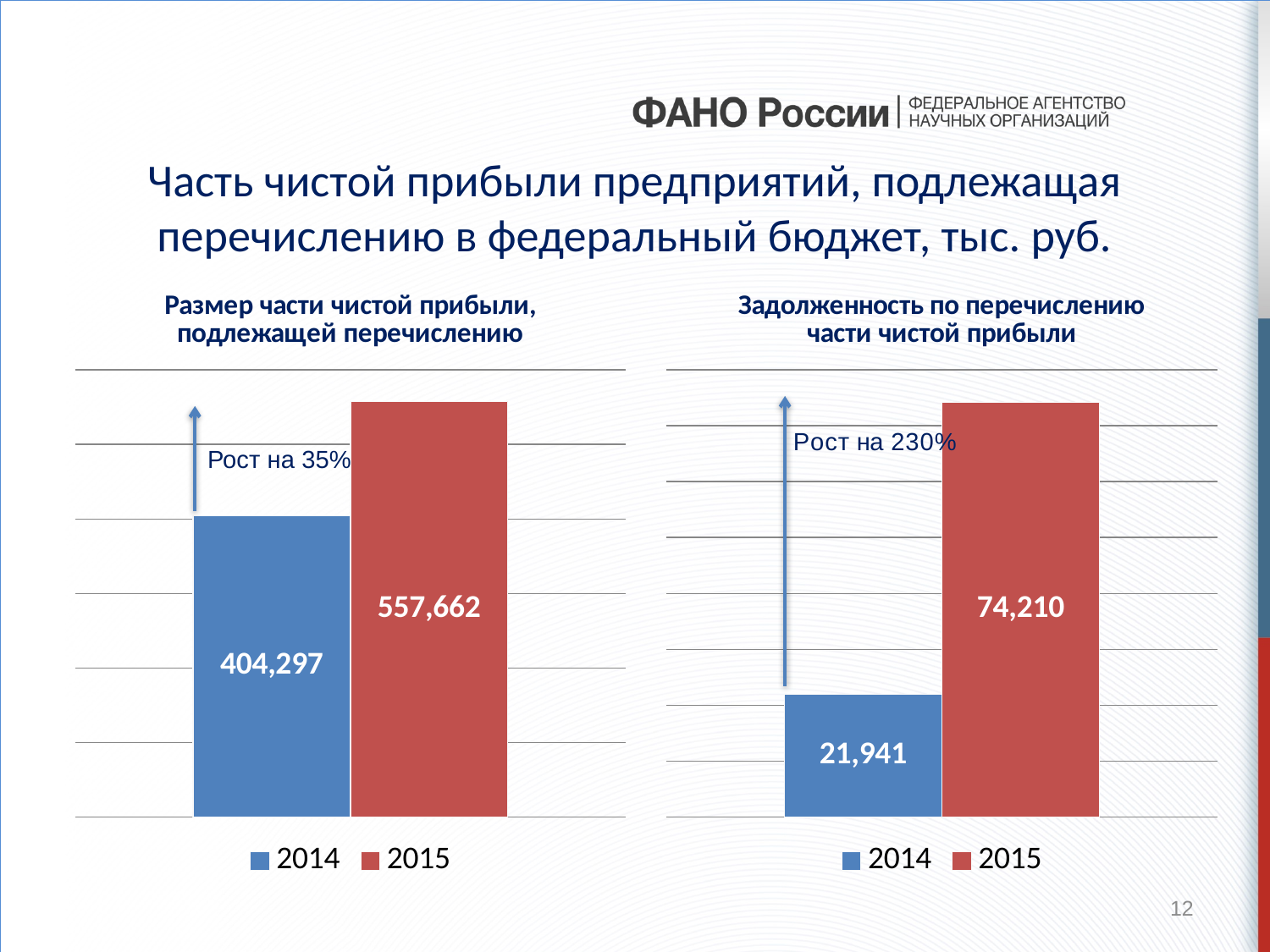
How many series does the legend of the left chart list? 2 In the left chart, by how much does the 2015 value exceed the 2014 value? 153,365 In the left chart, what growth percentage is annotated next to the arrow? Рост на 35% In the right chart, what growth percentage is annotated next to the arrow? Рост на 230% In the left chart (Размер части чистой прибыли, подлежащей перечислению), what is the value for 2015? 557,662 In the right chart (Задолженность по перечислению части чистой прибыли), what is the value for 2014? 21,941 In the right chart, what is the difference between the 2015 and 2014 values? 52,269 In the left chart (Размер части чистой прибыли, подлежащей перечислению), what is the value for 2014? 404,297 In the right chart (Задолженность по перечислению части чистой прибыли), what is the value for 2015? 74,210 In the right chart, which year has the higher value, 2014 or 2015? 2015 What type of chart is the right chart (Задолженность по перечислению части чистой прибыли)? Bar chart In the left chart, which year has the lowest value? 2014